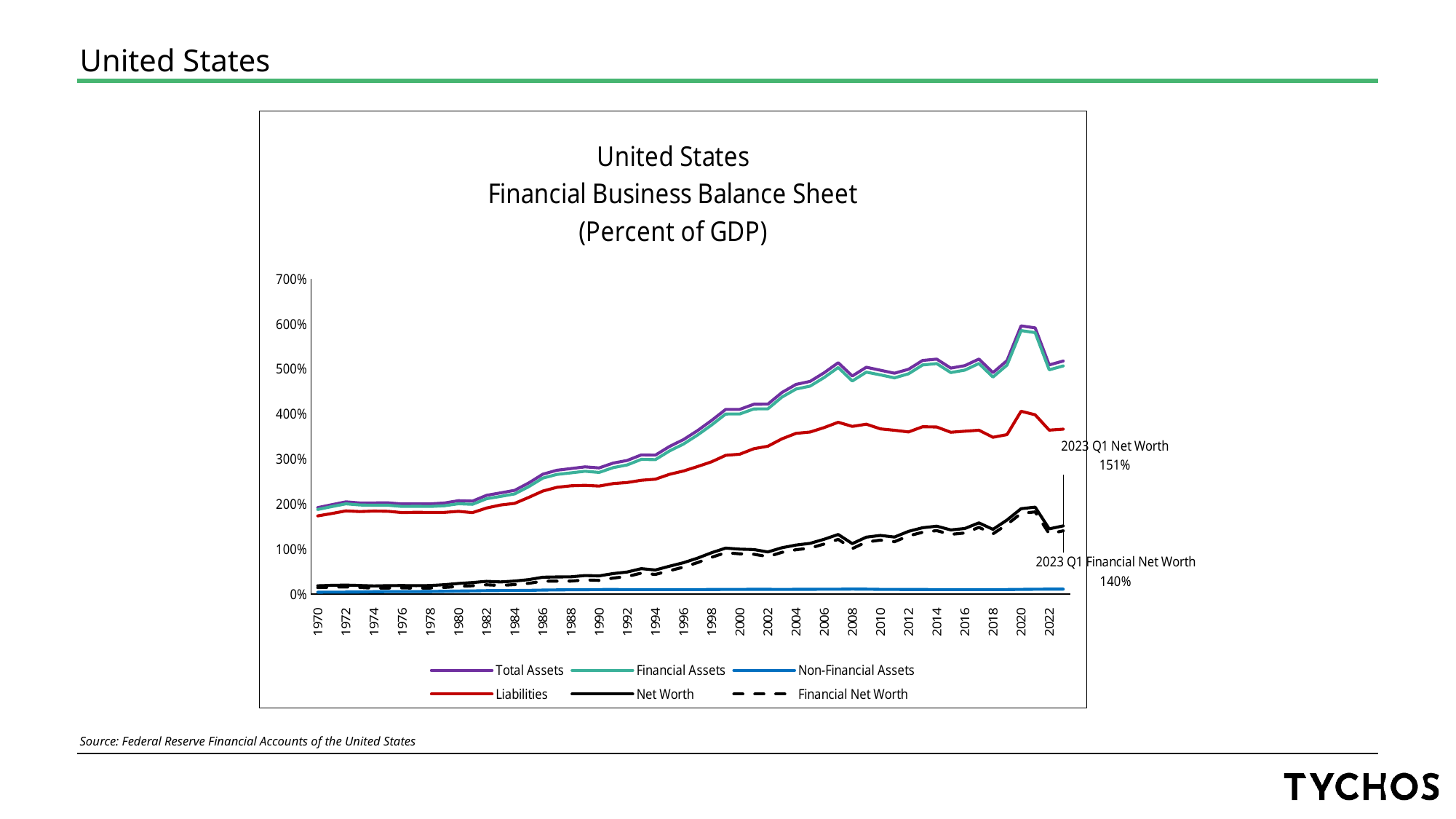
Do the Total Assets values generally rise or fall from 1970 to 2022? rise What is the 2023 Q1 Financial Net Worth value labelled on the chart? 140% In 2023 Q1, which is larger: Net Worth or Financial Net Worth? Net Worth Is the value for Total Assets in 2020 greater or less than 500%? greater Is the value for Liabilities in 1970 greater or less than 200%? less What is the 2023 Q1 Net Worth value labelled on the chart? 151% What is the difference between the labelled 2023 Q1 Net Worth and 2023 Q1 Financial Net Worth values? 11 percentage points Which series is drawn with a dashed line? Financial Net Worth How many series does the legend list? 6 Which series has the highest values across the chart? Total Assets Which series has the lowest values across the chart? Non-Financial Assets What kind of chart is shown on the slide? line chart